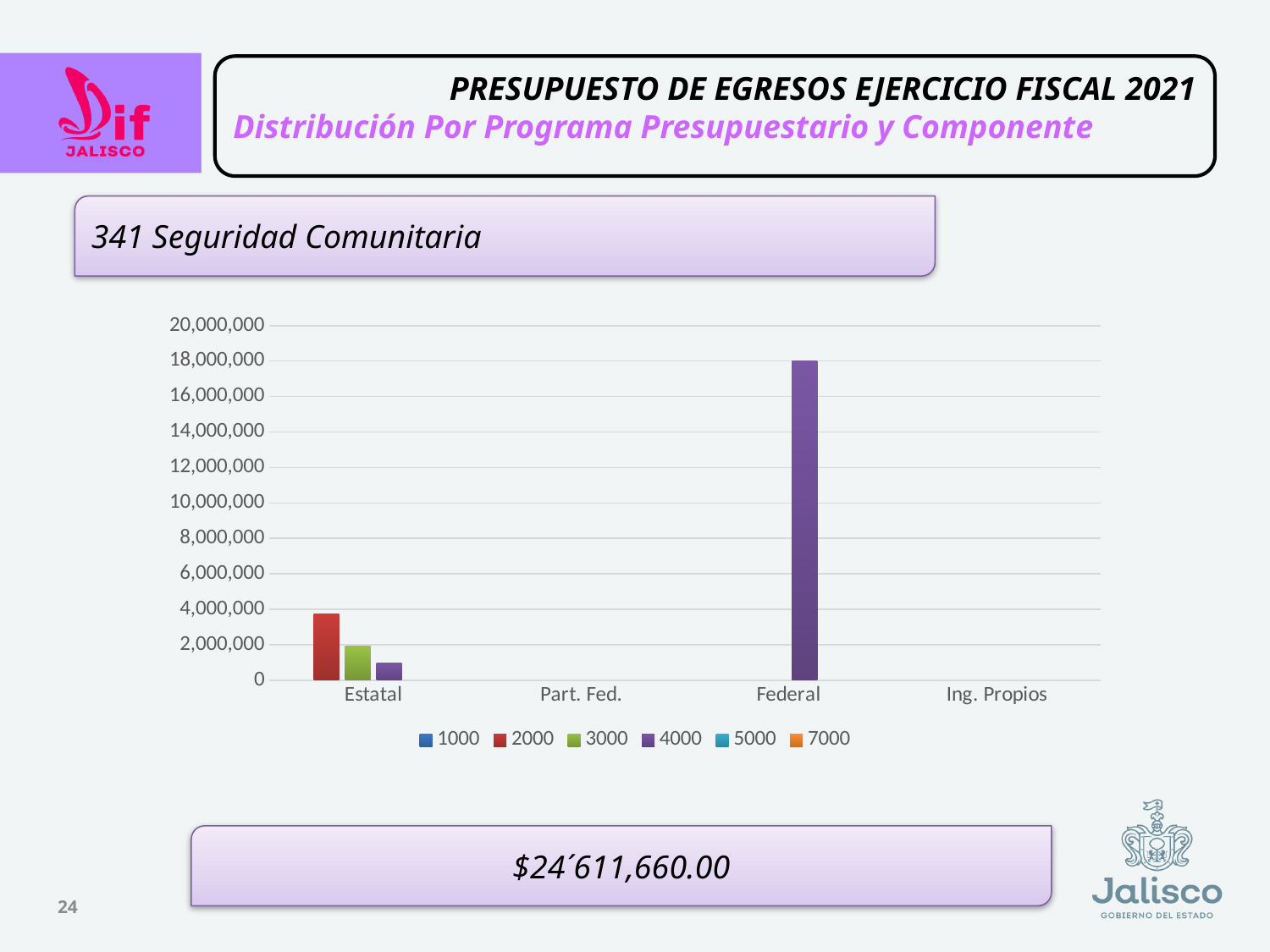
Which category has the tallest bar in the chart? Federal Is the value of the 2000 series for Estatal greater or less than 2,000,000? greater Is the value of the 3000 series for Estatal greater or less than 1,000,000? greater Is the value of the 4000 series for Federal greater or less than 16,000,000? greater What kind of chart is shown on the slide? bar chart How many categories are shown on the x axis of the chart? 4 Which series has the tallest bar in the Estatal category? 2000 In the Estatal category, which is larger: the 2000 series or the 3000 series? 2000 What is the name of the program shown above the chart? 341 Seguridad Comunitaria Which series has the tallest bar in the Federal category? 4000 How many series does the chart's legend list? 6